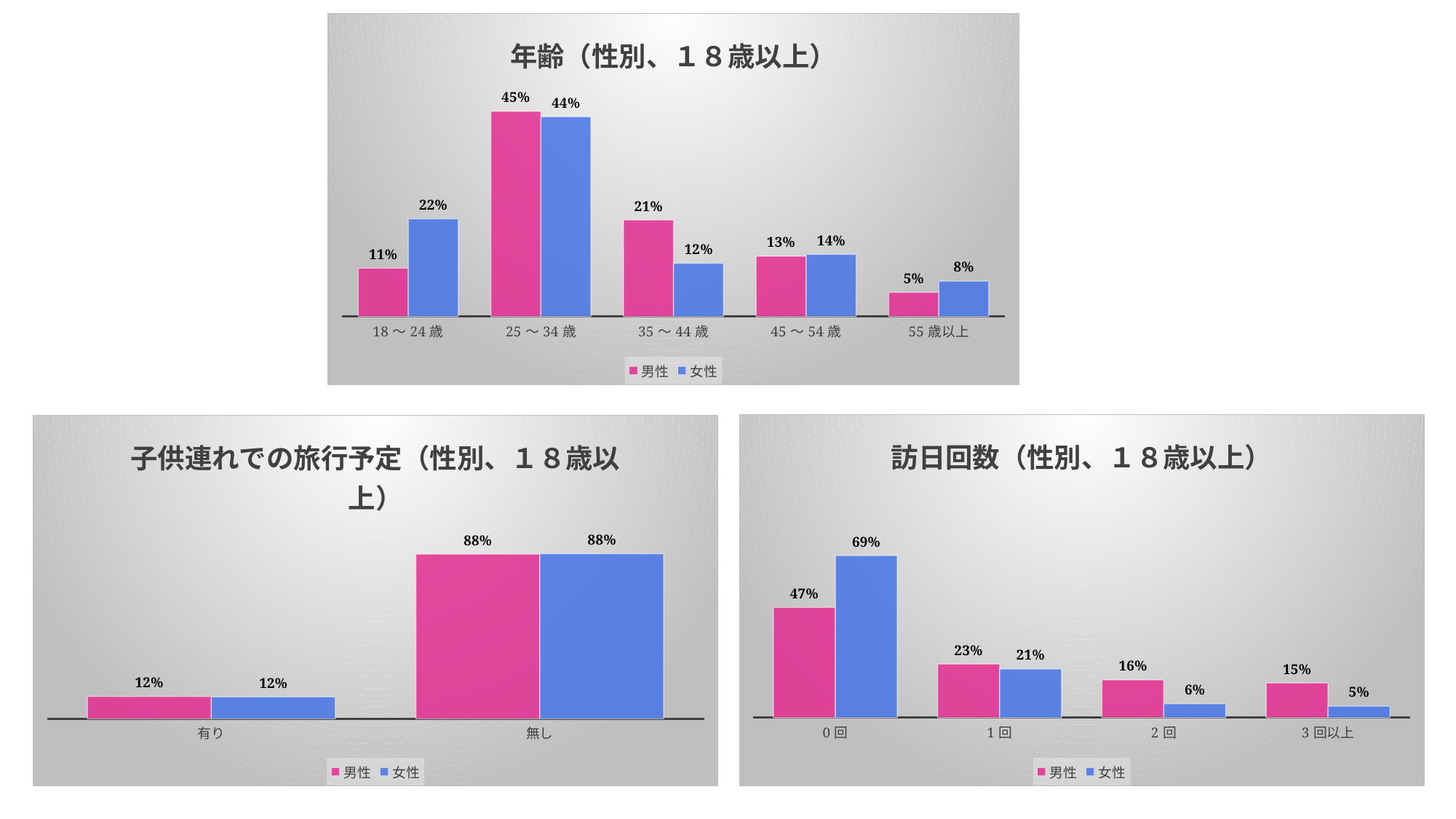
In the chart titled 年齢（性別、１８歳以上）, how many age categories are shown on the x axis? 5 In the chart titled 年齢（性別、１８歳以上）, what is the value for 女性 in the 18～24歳 category? 22% In the chart titled 年齢（性別、１８歳以上）, which age category has the lowest value for 男性? 55歳以上 In the chart titled 訪日回数（性別、１８歳以上）, what is the value for 女性 in the 0回 category? 69% In the chart titled 訪日回数（性別、１８歳以上）, which is larger in the 2回 category, 男性 or 女性? 男性 In the chart titled 年齢（性別、１８歳以上）, what is the difference between 男性 and 女性 in the 35～44歳 category? 9% What kind of chart is the chart titled 訪日回数（性別、１８歳以上）? Bar chart In the chart titled 子供連れでの旅行予定（性別、１８歳以上）, what is the difference between 無し and 有り for 男性? 76% In the chart titled 訪日回数（性別、１８歳以上）, how many series does the legend list? 2 In the chart titled 年齢（性別、１８歳以上）, what is the value for 男性 in the 25～34歳 category? 45% In the chart titled 子供連れでの旅行予定（性別、１８歳以上）, what is the value for 女性 in the 無し category? 88% In the chart titled 訪日回数（性別、１８歳以上）, what is the difference between 女性 and 男性 in the 0回 category? 22%